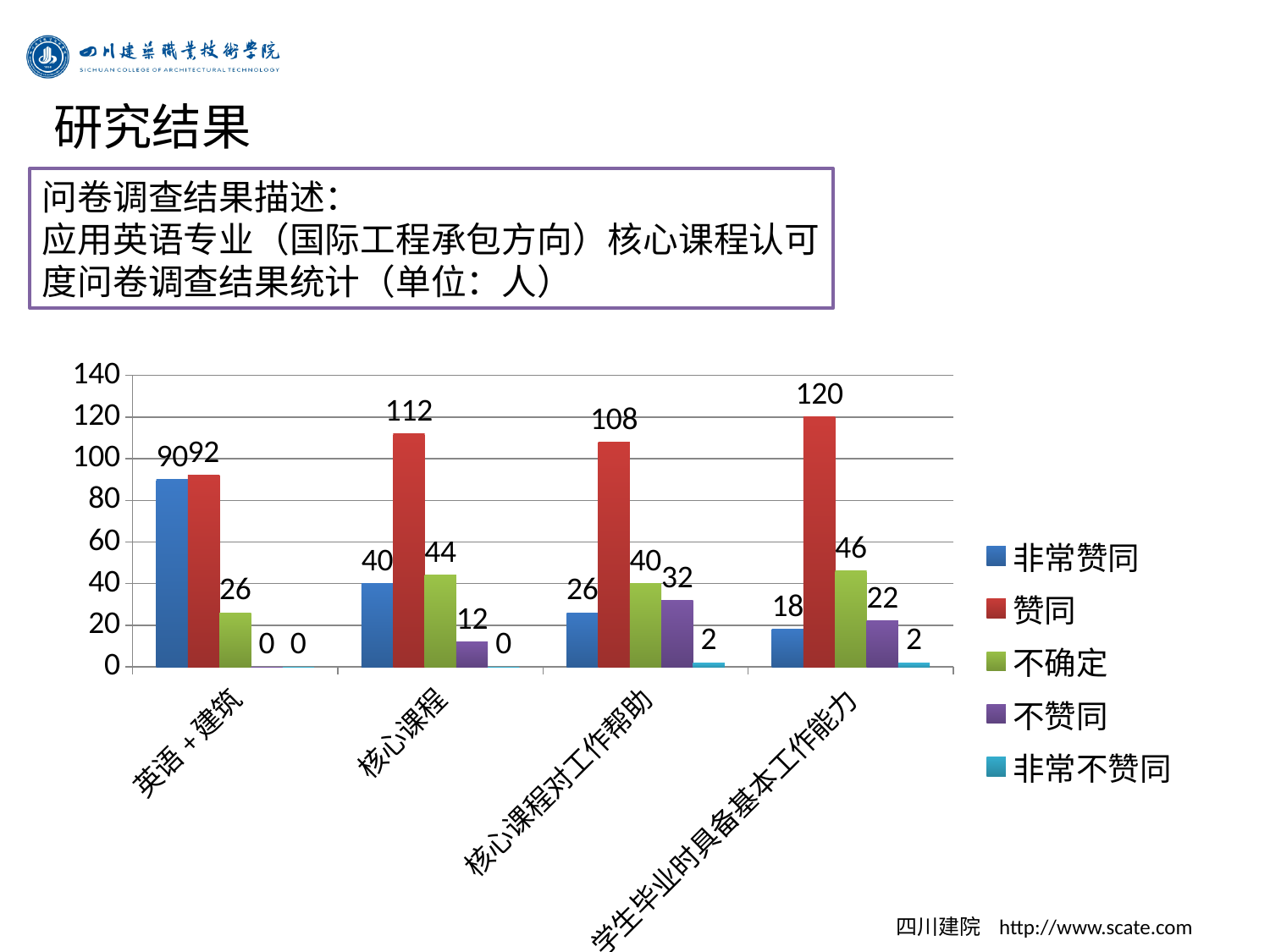
Which is larger for 核心课程: 非常赞同 or 不确定? 不确定 What is the value of 非常赞同 for 英语＋建筑? 90 How many categories are shown on the x axis? 4 Which category has the highest 赞同 value? 学生毕业时具备基本工作能力 What kind of chart is shown on the slide? bar chart What is the value of 赞同 for 核心课程? 112 Which category has the lowest 非常赞同 value? 学生毕业时具备基本工作能力 What is the difference between the 赞同 value for 学生毕业时具备基本工作能力 and the 赞同 value for 核心课程对工作帮助? 12 How many series does the legend list? 5 Does the 非常赞同 value rise or fall across the categories from left to right? fall Which legend entry is shown in red? 赞同 What is the value of 不赞同 for 核心课程对工作帮助? 32